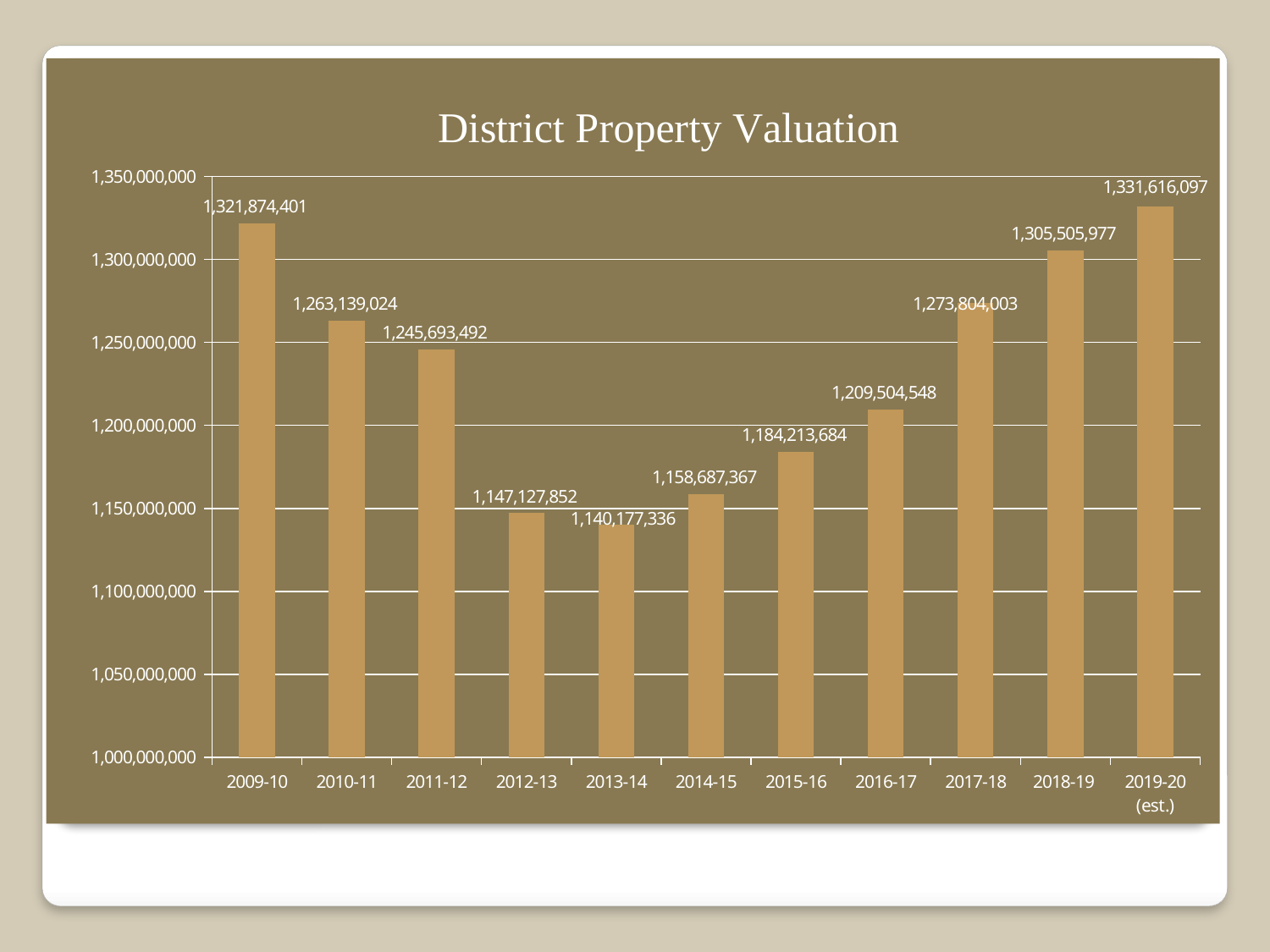
What is the estimated District Property Valuation for 2019-20? 1,331,616,097 What is the difference between the 2018-19 and 2017-18 valuations? 31,701,974 Which is larger, the valuation for 2010-11 or for 2017-18? 2017-18 How much higher is the 2019-20 (est.) valuation than the 2009-10 valuation? 9,741,696 How many years are shown on the x axis of the chart? 11 What is the District Property Valuation for 2015-16? 1,184,213,684 What kind of chart is shown on the slide? bar chart Which year has the highest District Property Valuation? 2019-20 (est.) Is the valuation for 2016-17 greater or less than 1,200,000,000? greater What is the District Property Valuation for 2009-10? 1,321,874,401 How does the District Property Valuation change from 2013-14 to 2019-20 (est.)? It rises every year Which year has the lowest District Property Valuation? 2013-14